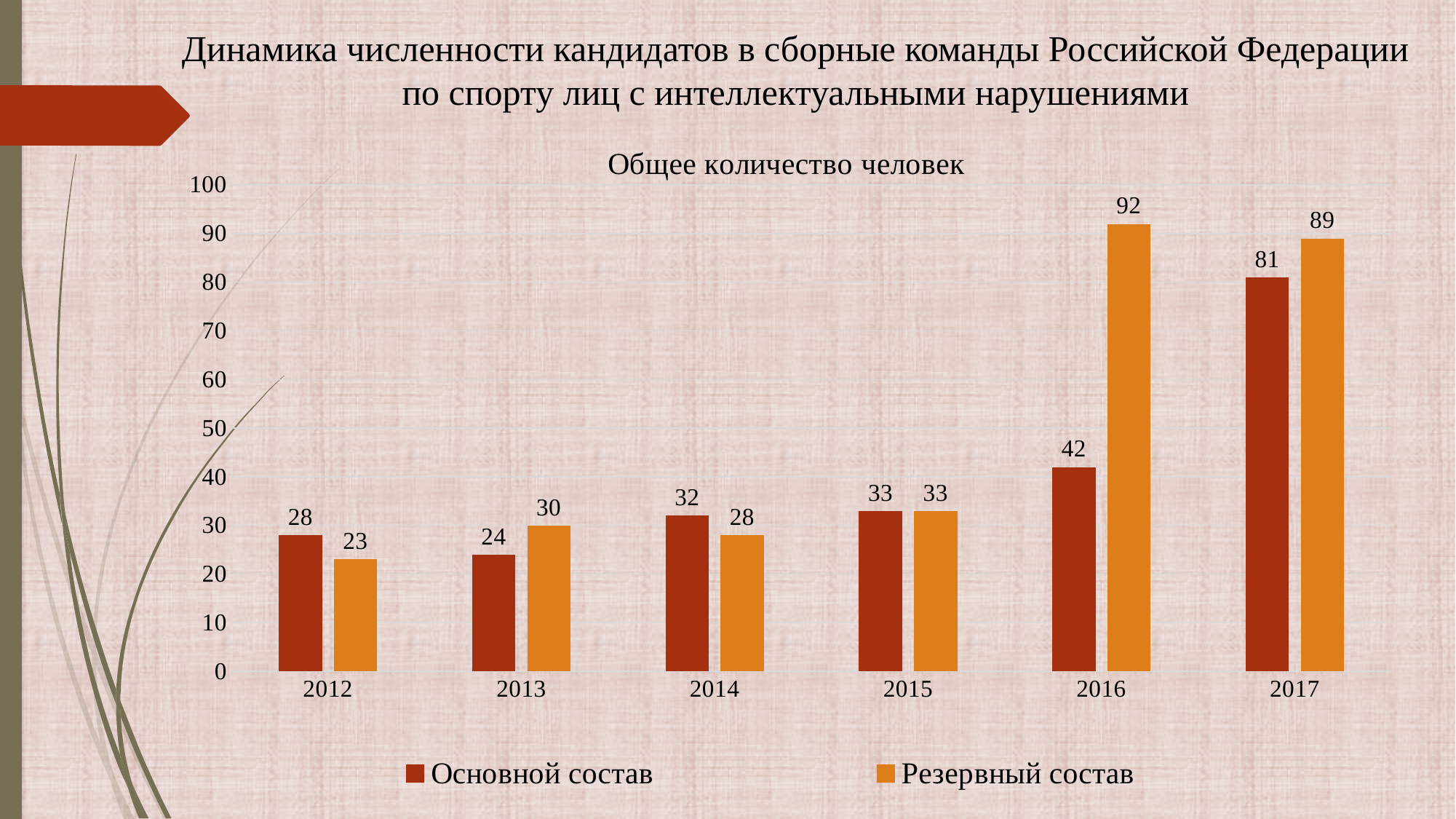
In which year is the Основной состав value lowest? 2013 How many series does the legend list? 2 Does the Резервный состав value rise or fall from 2015 to 2016? Rise How many years are shown on the x axis? 6 What kind of chart is shown on the slide? Bar chart In which year is the Резервный состав value highest? 2016 What is the difference between Резервный состав and Основной состав in 2016? 50 What is the value for Резервный состав in 2013? 30 Which is larger in 2014: Основной состав or Резервный состав? Основной состав What is the value for Основной состав in 2017? 81 What is the value for Основной состав in 2016? 42 What is the chart's title? Общее количество человек